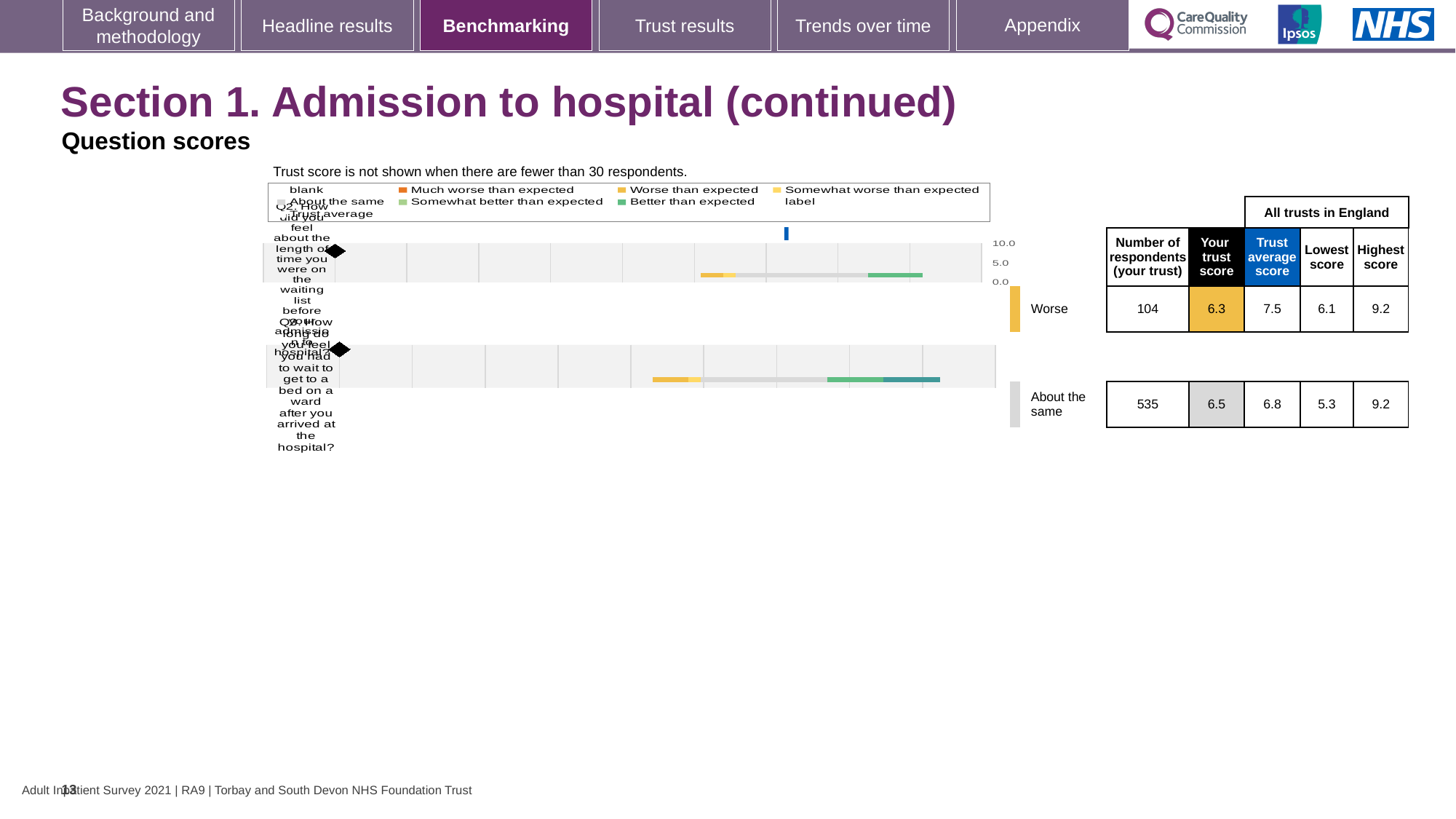
What is the lowest score across all trusts in England for Q3? 5.3 What is the trust average score across all trusts in England for Q2? 7.5 How many respondents answered Q2 at this trust? 104 What benchmark category is shown for Q2? Worse How many respondents answered Q3 at this trust? 535 How many questions are plotted on the chart? 2 What is the trust score for Q2 (how did you feel about the length of time on the waiting list before admission)? 6.3 What is the difference between the number of respondents for Q3 and Q2? 431 Is the trust score for Q2 greater or less than 5.0? greater What kind of chart is used to show the question scores? bar chart What is the trust score for Q3 (how long did you feel you had to wait to get to a bed on a ward)? 6.5 Which question has the higher trust score, Q2 or Q3? Q3